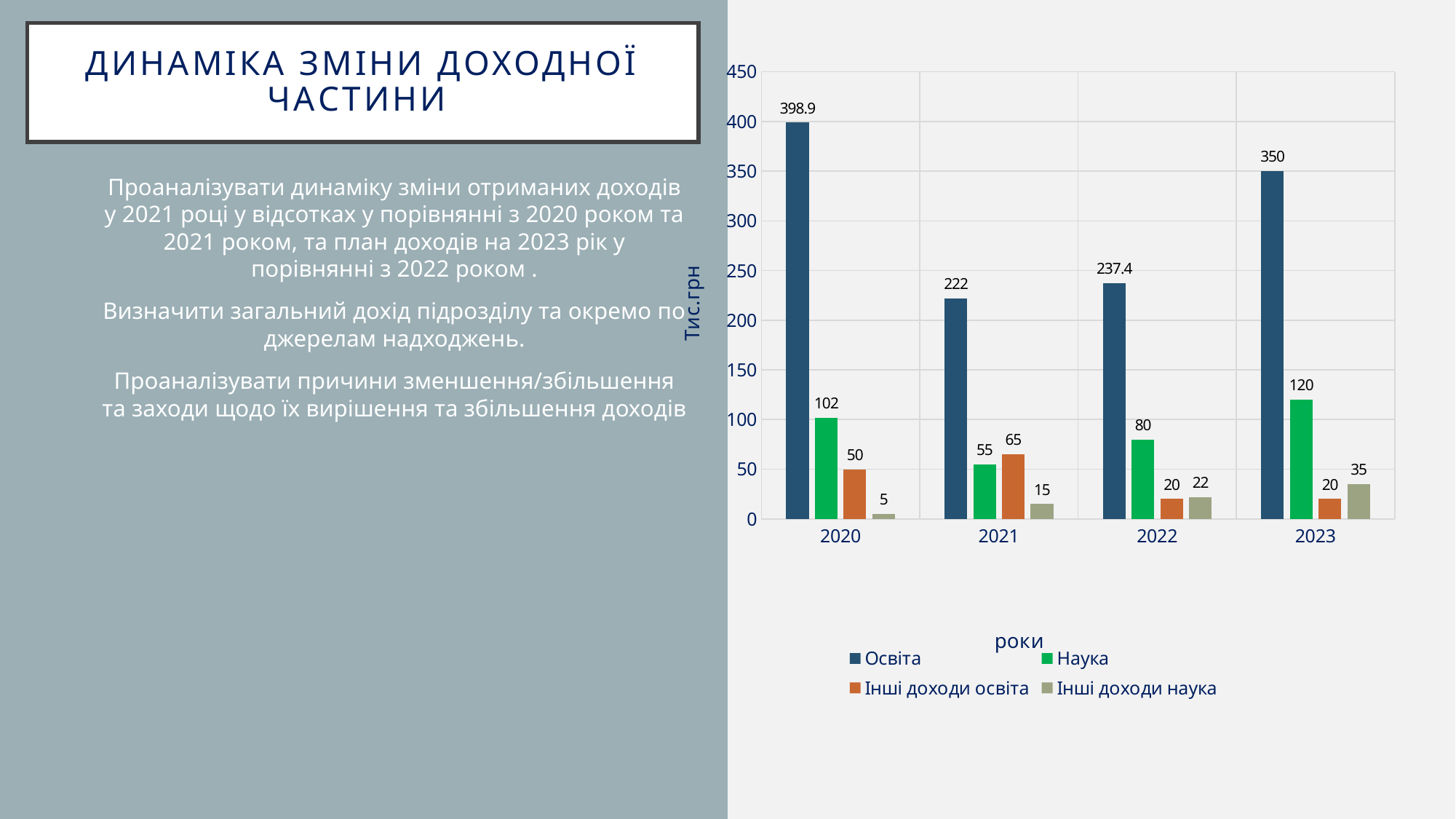
What is the value for Освіта in 2020? 398.9 What is the difference between the Освіта values for 2023 and 2021? 128 How many years are shown on the x axis? 4 In which year is the value for Інші доходи наука the lowest? 2020 What is the value for Інші доходи наука in 2022? 22 What kind of chart is shown on the slide? Bar chart How many series does the legend list? 4 What is the value for Наука in 2023? 120 What is the label of the vertical axis? Тис.грн What is the value for Інші доходи освіта in 2021? 65 In which year is the value for Освіта the highest? 2020 Which is larger in 2021: Наука or Інші доходи освіта? Інші доходи освіта